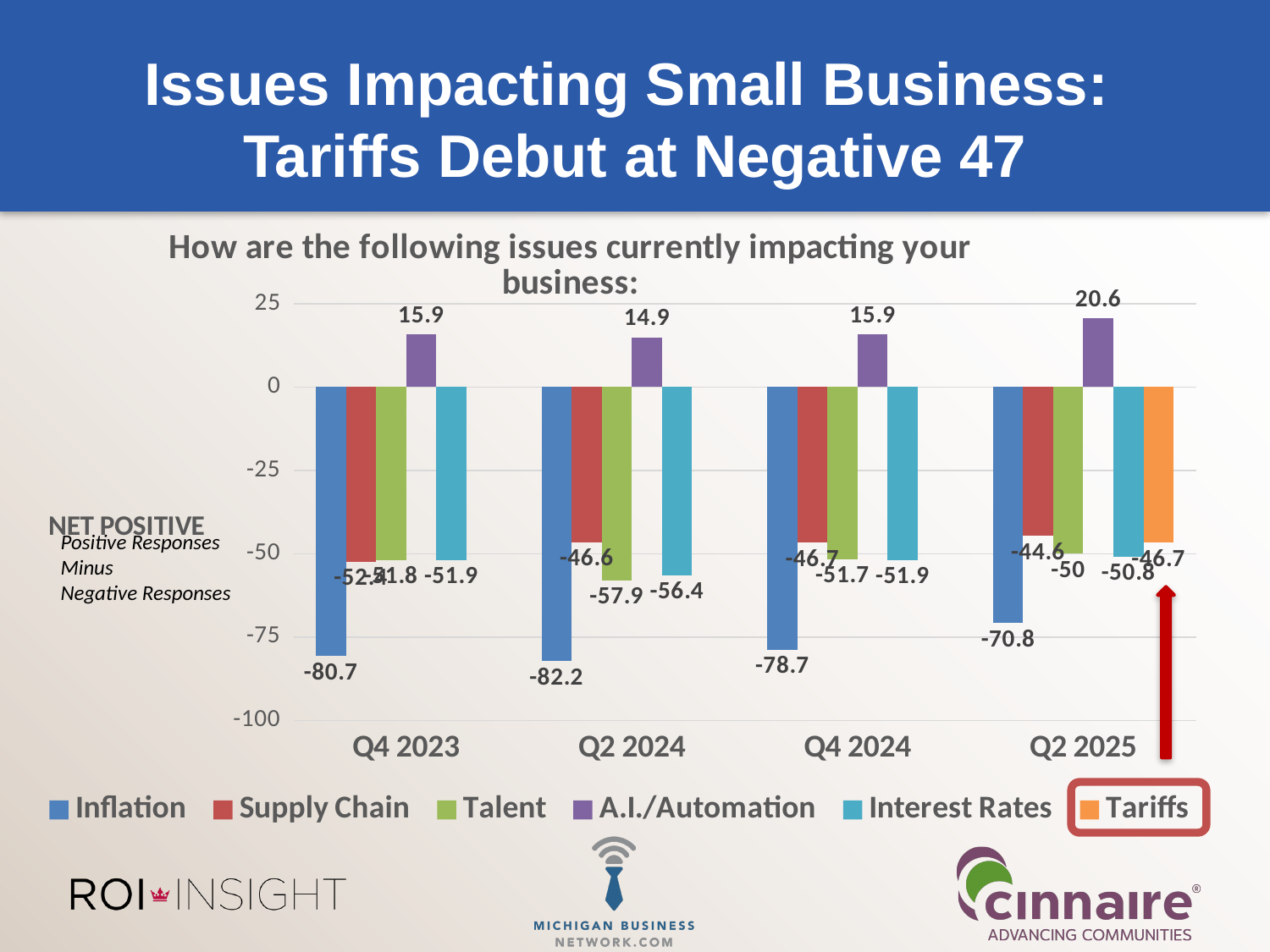
What is the value for Supply Chain in Q2 2024? -46.6 Which has the lower value in Q2 2024, Talent or Interest Rates? Talent Is the value for Inflation in Q4 2023 greater or less than -75? less In which quarter is the A.I./Automation value highest? Q2 2025 What is the value for Tariffs in Q2 2025? -46.7 What is the difference between the Inflation values for Q4 2023 and Q2 2025? 9.9 What is the value for A.I./Automation in Q2 2025? 20.6 In which quarter is the Inflation value lowest? Q2 2024 What is the value for Inflation in Q2 2025? -70.8 How many quarters are shown on the x axis? 4 How many series does the legend list? 6 What kind of chart is shown on the slide? bar chart